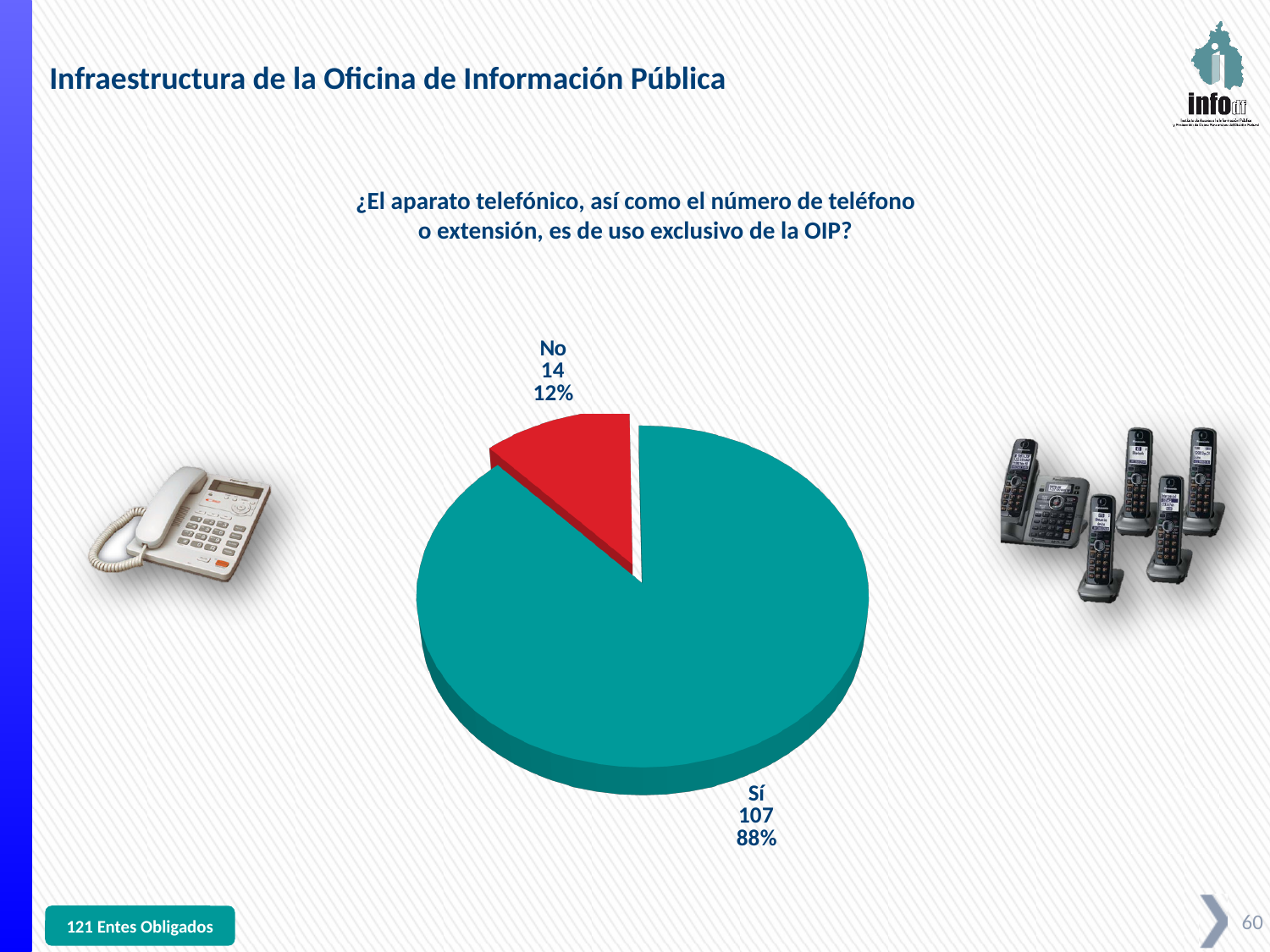
How many slices does the pie chart have? 2 What is the count for the "No" slice? 14 What is the count for the "Sí" slice? 107 What kind of chart is shown on the slide? pie chart What colour is the "No" slice? red Which is larger, the count for "Sí" or the count for "No"? Sí Which slice is the largest? Sí What percentage share does the "No" slice represent? 12% Which slice is the smallest? No What is the total of the two slice counts? 121 What percentage share does the "Sí" slice represent? 88% What is the difference between the counts for "Sí" and "No"? 93